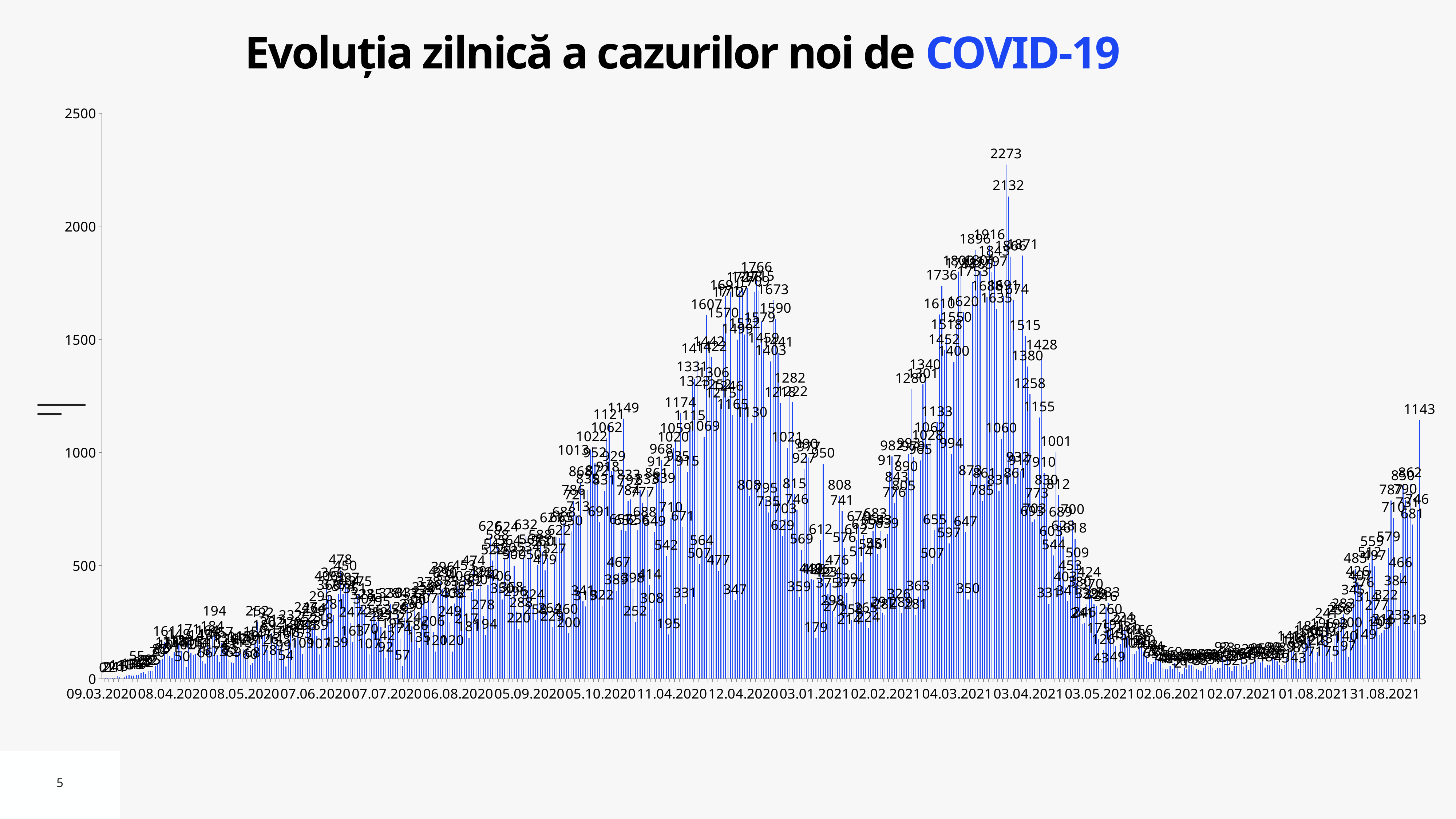
Do the values rise or fall between 03.04.2021 and 02.06.2021? fall Are the values around 02.06.2021 greater or less than 500? less Is the value of the rightmost bar greater or less than 1000? greater What is the second highest value labeled on the chart, just below the 2273 peak? 2132 Is the highest value on the chart greater or less than 2000? greater What kind of chart is shown on the slide? bar chart What is the title of the chart? Evoluția zilnică a cazurilor noi de COVID-19 What is the highest tick value shown on the vertical axis? 2500 What is the value labeled on the last (rightmost) bar of the chart? 1143 What is the highest daily value labeled on the chart? 2273 What is the difference between the two highest labeled values, 2273 and 2132? 141 Do the values rise or fall between 01.08.2021 and the end of the chart? rise